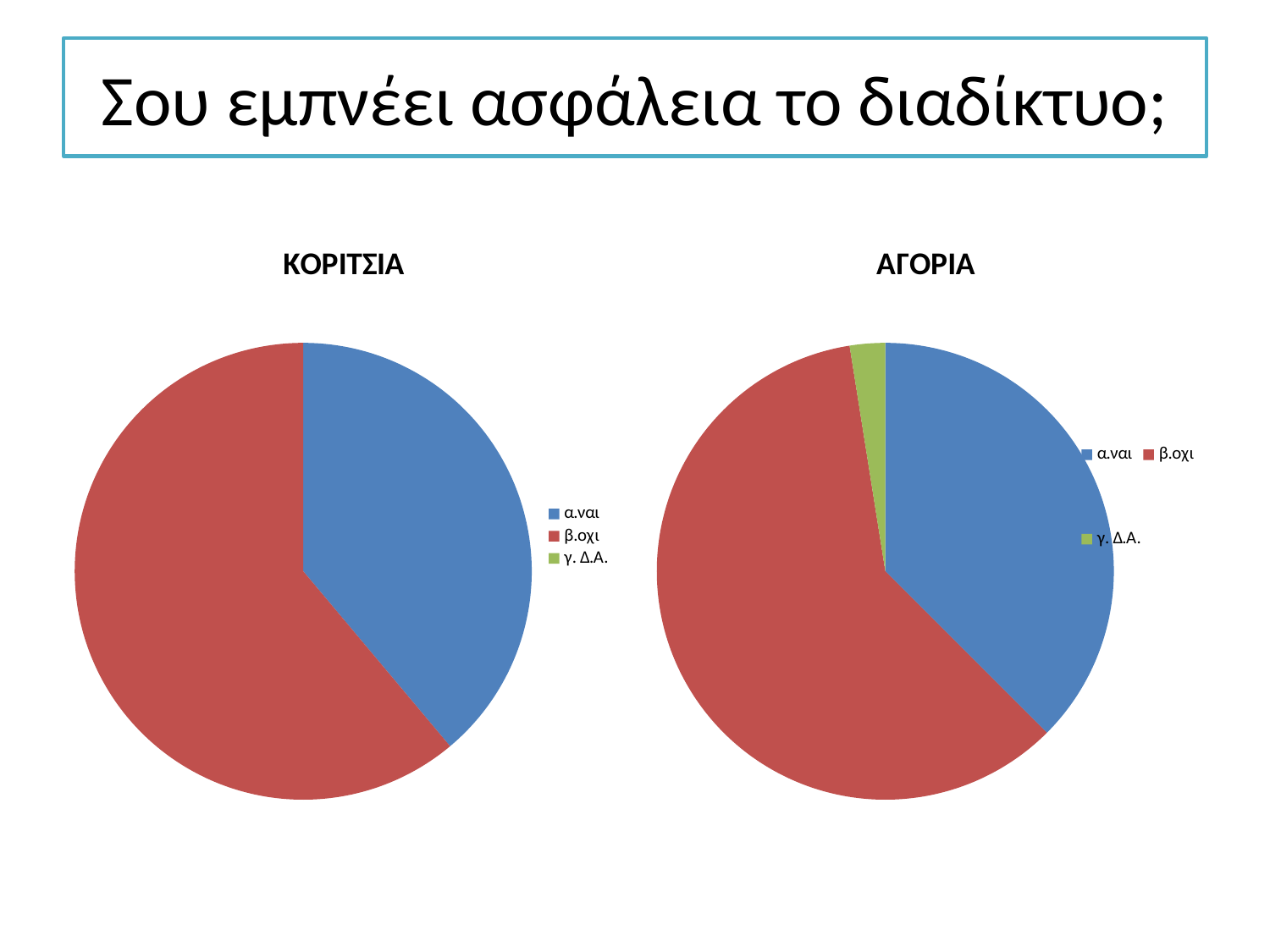
What kind of chart is the ΚΟΡΙΤΣΙΑ chart? pie chart In the ΚΟΡΙΤΣΙΑ chart, which slice is larger, α.ναι or β.οχι? β.οχι In the ΑΓΟΡΙΑ chart, what colour is the γ. Δ.Α. slice? green In the ΑΓΟΡΙΑ chart, which category has the smallest slice? γ. Δ.Α. How many categories does the legend of the ΚΟΡΙΤΣΙΑ chart list? 3 How many categories does the legend of the ΑΓΟΡΙΑ chart list? 3 How many pie charts are shown on the slide? 2 In the ΑΓΟΡΙΑ chart, which slice is larger, α.ναι or γ. Δ.Α.? α.ναι What is the title of the pie chart on the left? ΚΟΡΙΤΣΙΑ What kind of chart is the ΑΓΟΡΙΑ chart? pie chart In the ΚΟΡΙΤΣΙΑ chart, which category has the largest slice? β.οχι In the ΑΓΟΡΙΑ chart, which category has the largest slice? β.οχι